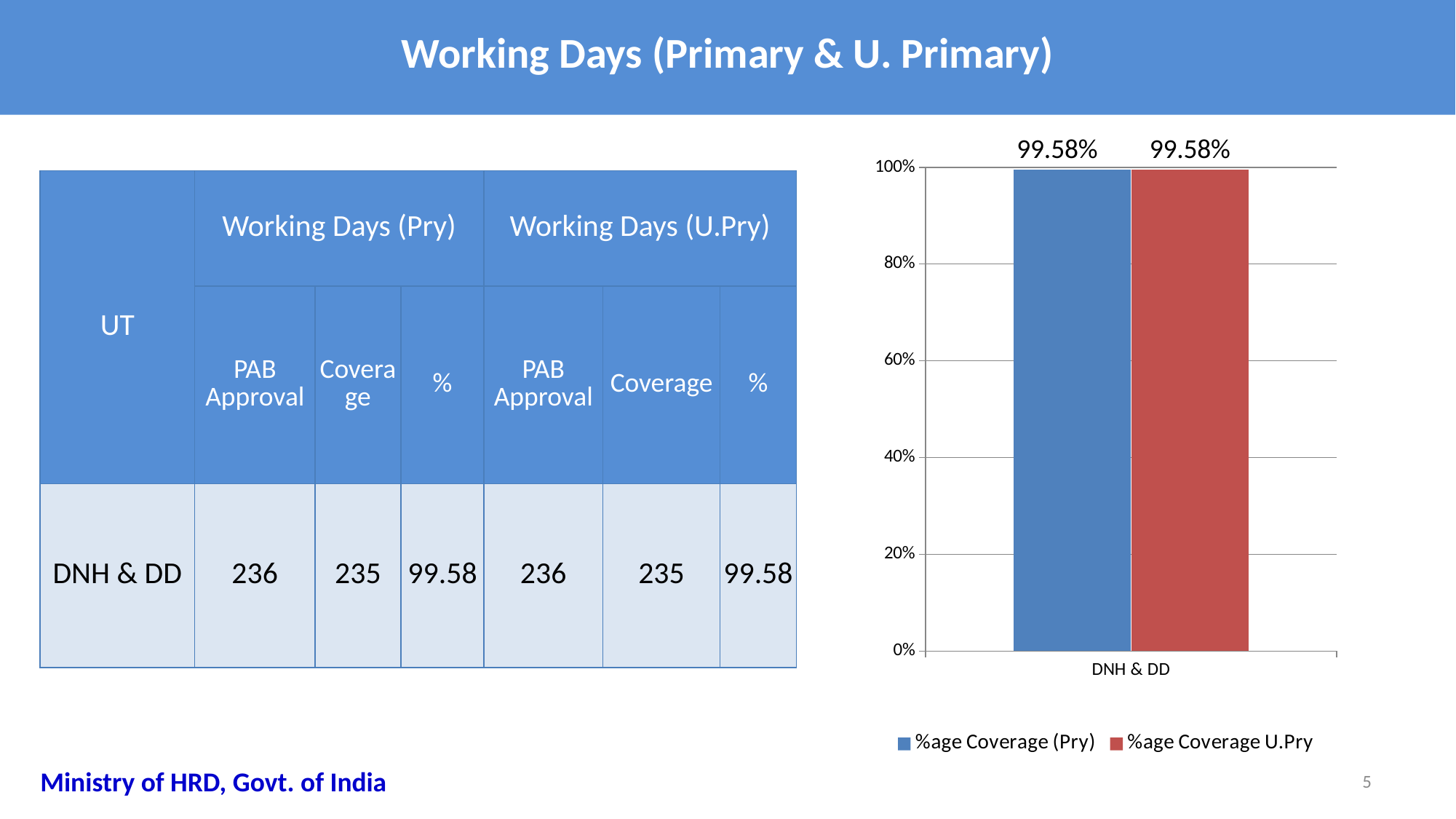
How many categories are shown on the x axis of the chart? 1 Is the value for %age Coverage U.Pry for DNH & DD greater or less than 60%? greater How many series does the chart legend list? 2 Is the value for %age Coverage (Pry) for DNH & DD greater or less than 80%? greater What is the value of the %age Coverage (Pry) bar for DNH & DD? 99.58% What is the value of the %age Coverage U.Pry bar for DNH & DD? 99.58% What is the difference between the %age Coverage (Pry) and %age Coverage U.Pry values for DNH & DD? 0% What kind of chart is shown on the slide? Bar chart What is the category label shown on the x axis of the chart? DNH & DD Which series is shown in red in the chart? %age Coverage U.Pry